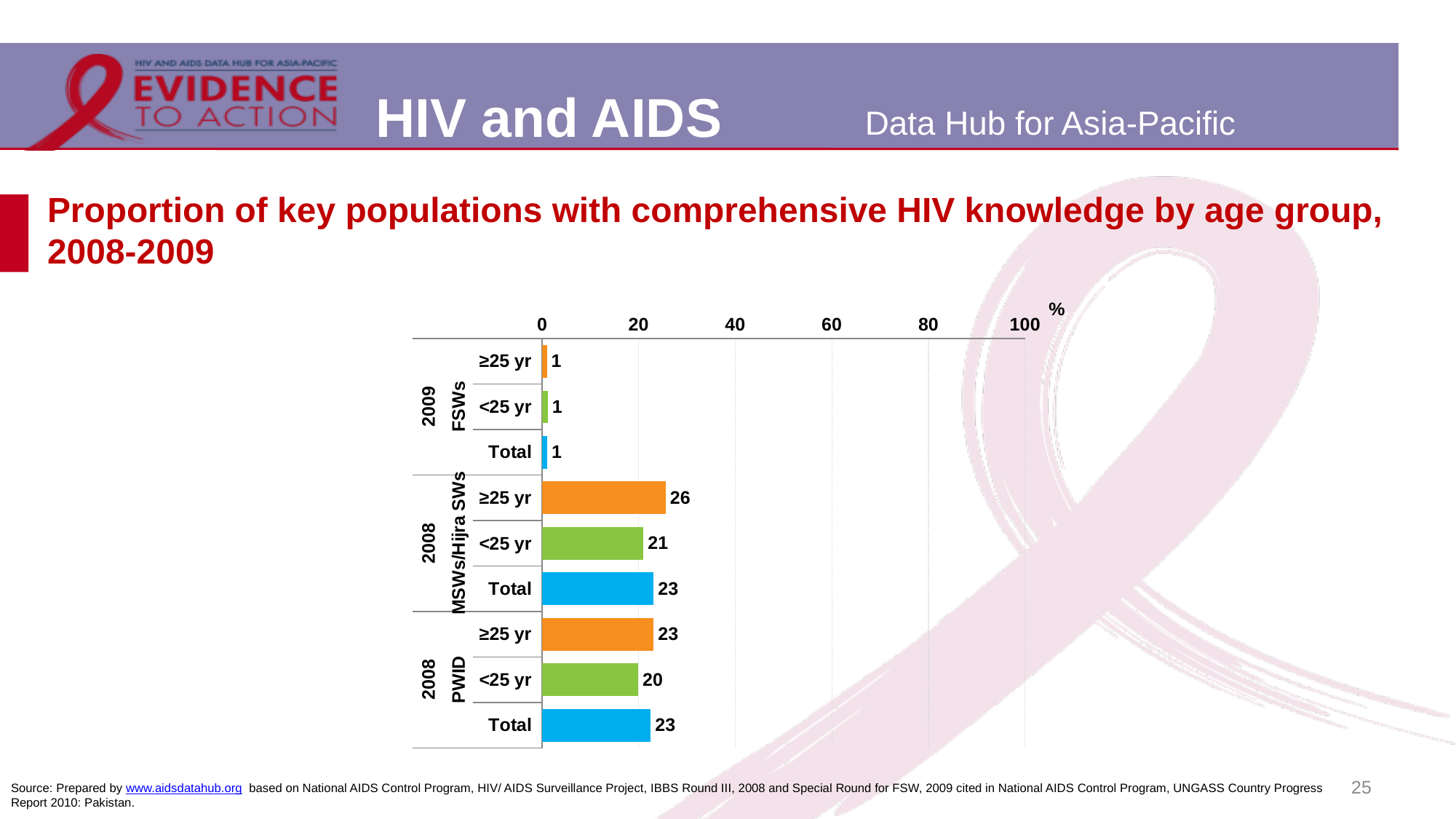
What is the Total value for MSWs/Hijra SWs (2008)? 23 What is the value for ≥25 yr among MSWs/Hijra SWs (2008)? 26 Which bar has the highest value on the chart? MSWs/Hijra SWs ≥25 yr What kind of chart is shown on the slide? Bar chart What is the difference between the ≥25 yr and <25 yr values for PWID (2008)? 3 Is the value for ≥25 yr among MSWs/Hijra SWs greater or less than 40? less Which is larger: the <25 yr value for MSWs/Hijra SWs or the <25 yr value for PWID? MSWs/Hijra SWs <25 yr How many bars are plotted on the chart? 9 What is the Total value for FSWs (2009)? 1 What is the value for <25 yr among PWID (2008)? 20 What is the maximum value shown on the horizontal axis? 100 What is the difference between the ≥25 yr and <25 yr values for MSWs/Hijra SWs (2008)? 5